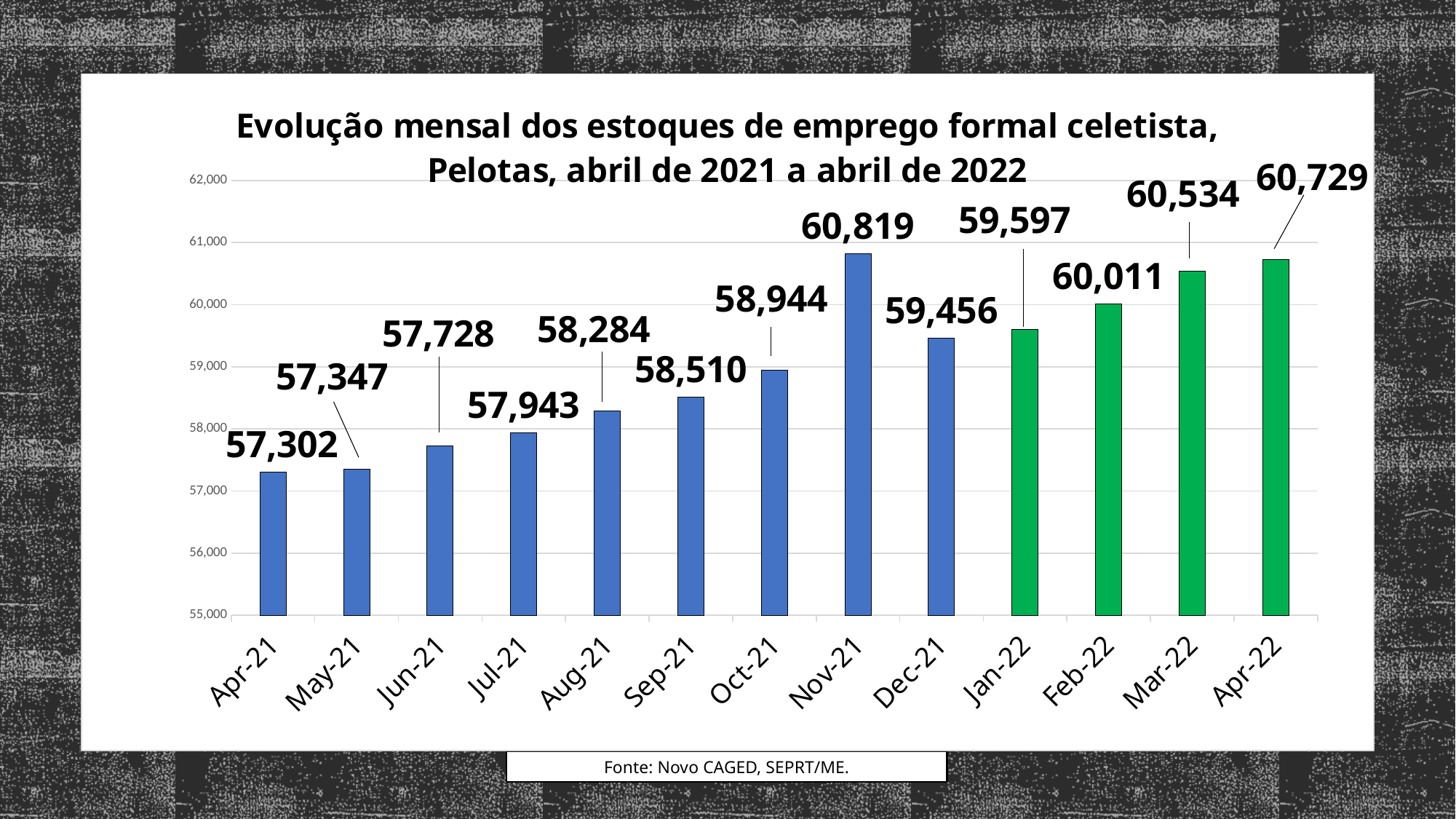
How many bars are coloured green? 4 What is the value for Nov-21? 60,819 What is the value for Feb-22? 60,011 Which month has the highest value? Nov-21 What is the value for Apr-21? 57,302 What is the difference between the values for Nov-21 and Dec-21? 1,363 Which is larger, the value for Dec-21 or the value for Jan-22? Jan-22 Is the value for Sep-21 greater or less than 59,000? less What is the difference between the values for Apr-22 and Apr-21? 3,427 How many months are shown on the x axis? 13 Which month has the lowest value? Apr-21 What kind of chart is shown on the slide? bar chart